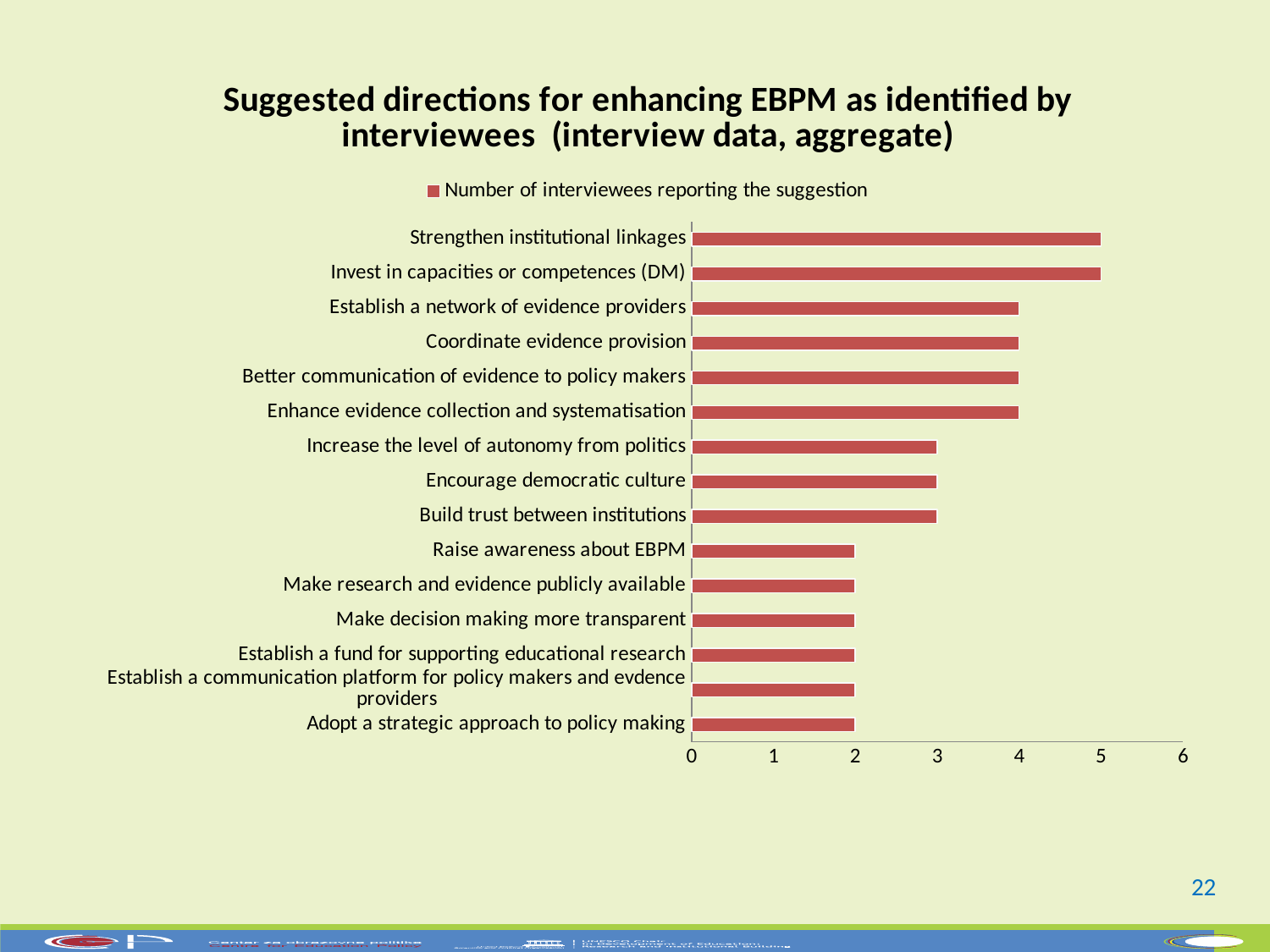
What is the difference between the values for Strengthen institutional linkages and Raise awareness about EBPM? 3 How many series does the legend list? 1 Which has a larger value, Invest in capacities or competences (DM) or Build trust between institutions? Invest in capacities or competences (DM) What is the value for Increase the level of autonomy from politics? 3 What is the value for Establish a network of evidence providers? 4 What is the value for Strengthen institutional linkages? 5 Which has a larger value, Coordinate evidence provision or Encourage democratic culture? Coordinate evidence provision What kind of chart is shown on the slide? bar chart How many categories are shown in the chart? 15 Is the value for Build trust between institutions greater or less than 4? less What is the value for Adopt a strategic approach to policy making? 2 Is the value for Better communication of evidence to policy makers greater or less than 3? greater